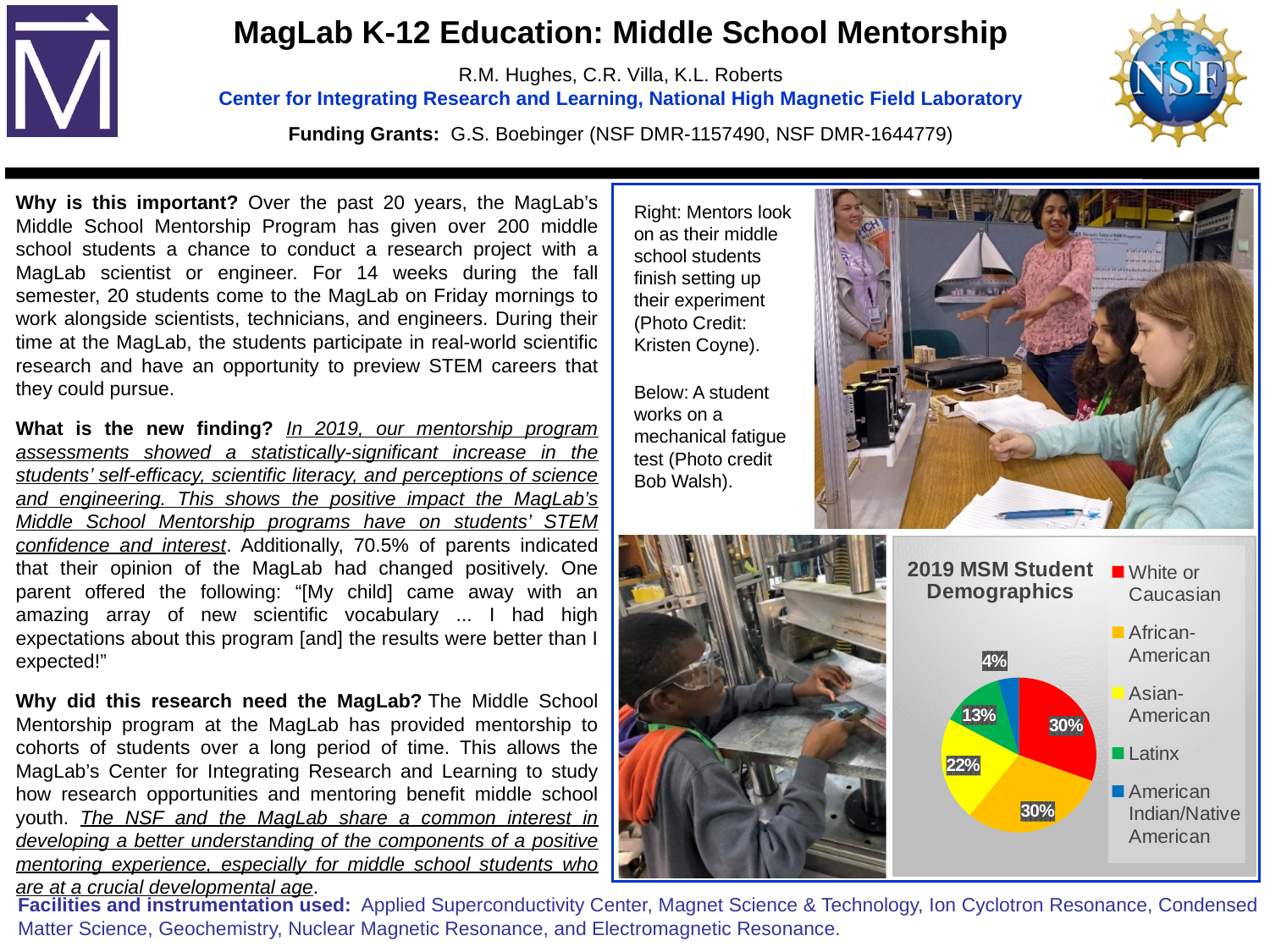
What percentage is shown for Latinx students? 13% How many categories does the legend of the pie chart list? 5 What kind of chart is shown on the slide? pie chart Which category has the smallest slice of the pie? American Indian/Native American What percentage is shown for Asian-American students? 22% What percentage is shown for American Indian/Native American students? 4% What share of the pie is White or Caucasian? 30% What is the title of the chart? 2019 MSM Student Demographics How many slices does the pie chart have? 5 Which slice is larger, Latinx or Asian-American? Asian-American What percentage is shown for African-American students? 30% What is the difference in percentage points between the Asian-American and Latinx slices? 9%